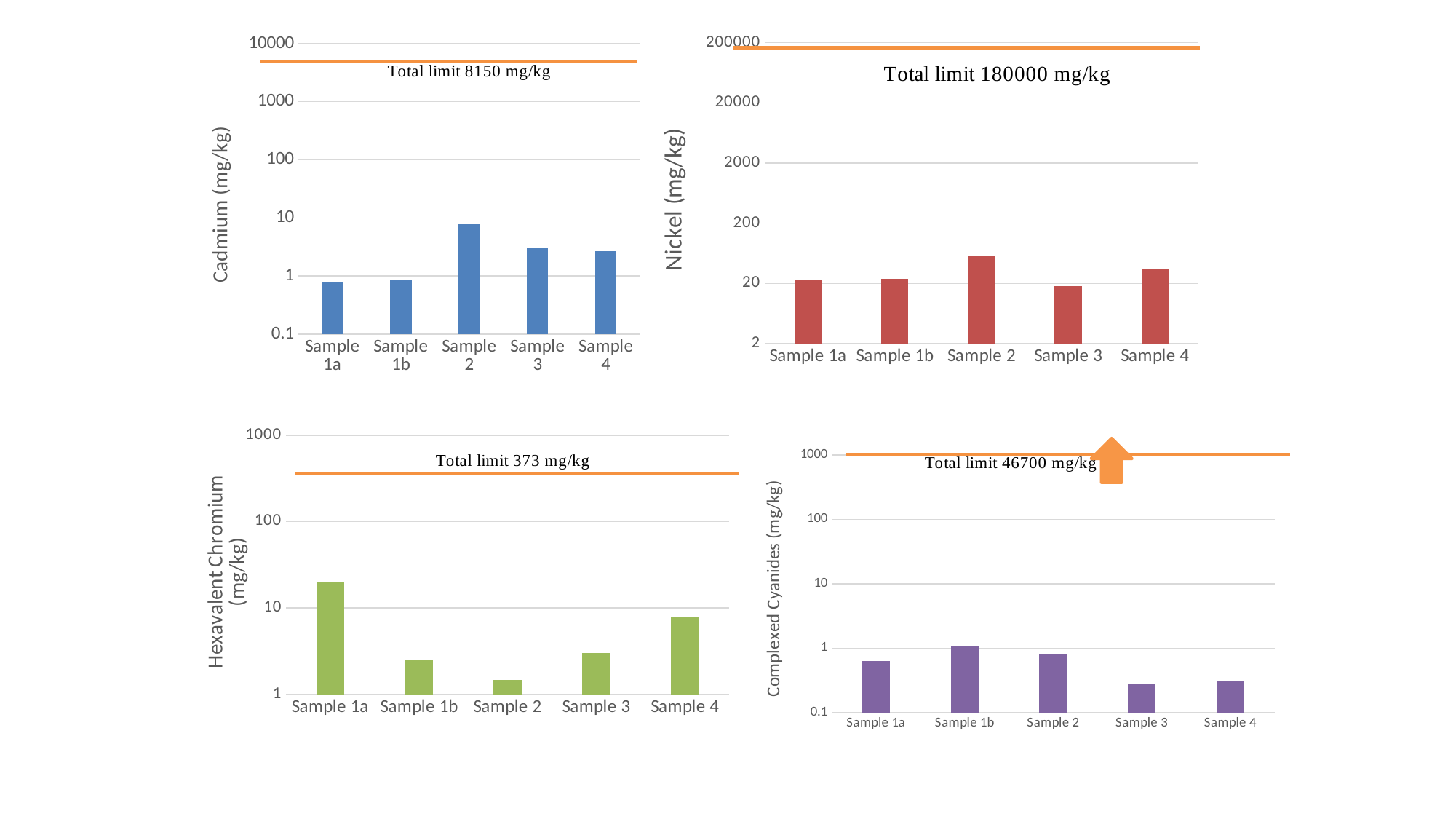
In the Nickel chart, which sample has the highest value? Sample 2 In the Complexed Cyanides chart, is the value for Sample 3 greater or less than 1? less How many samples are shown on the x axis of the Nickel chart? 5 In the Hexavalent Chromium chart, is the value for Sample 1a greater or less than 10? greater In the Hexavalent Chromium chart, which sample has the lowest value? Sample 2 In the Complexed Cyanides chart, which sample has the highest value? Sample 1b In the Cadmium chart, is the value for Sample 2 greater or less than 1? greater What total limit is stated on the Hexavalent Chromium chart? 373 mg/kg In the Hexavalent Chromium chart, which sample has the highest value? Sample 1a